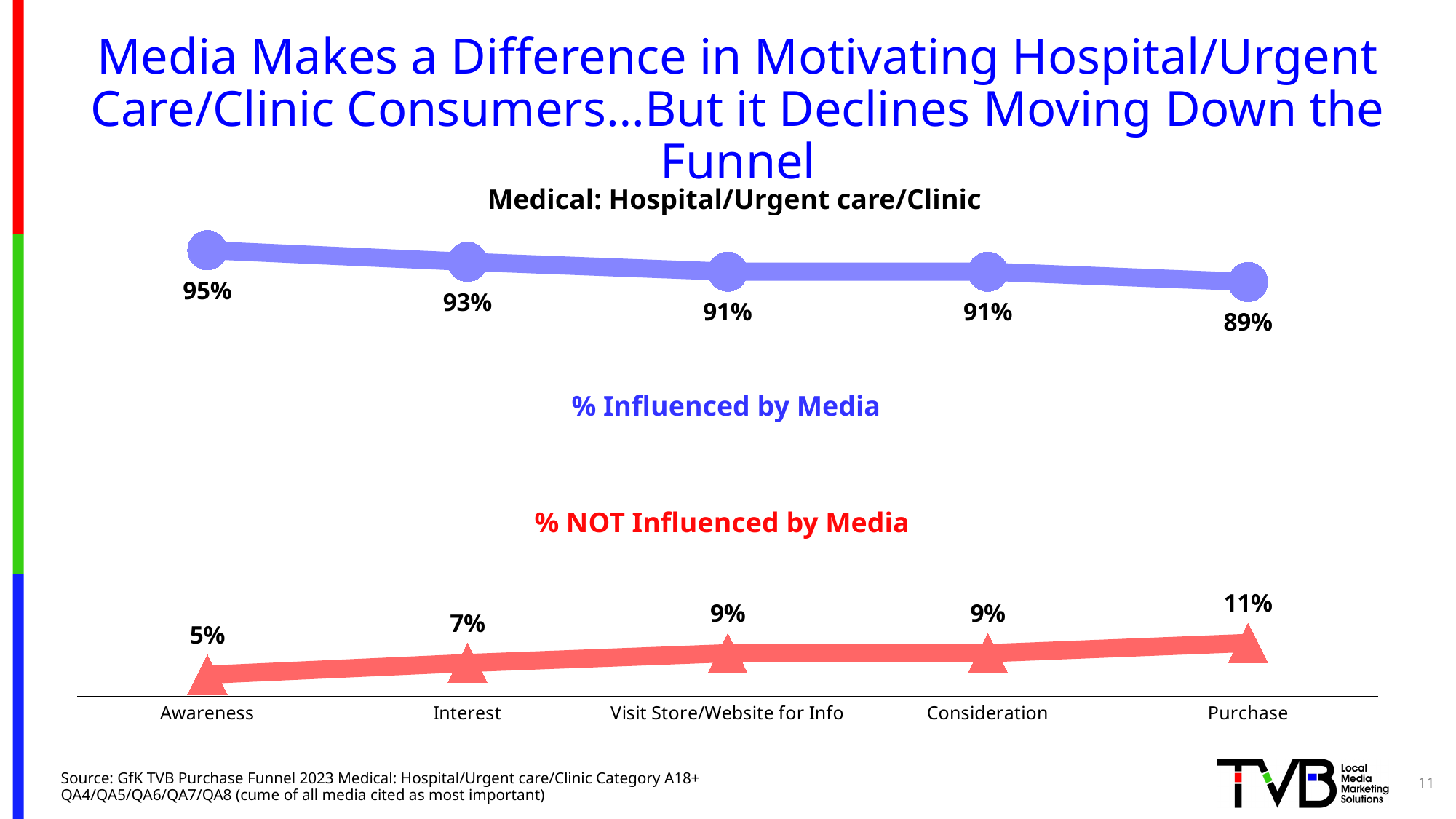
Does the % Influenced by Media series rise or fall moving from Awareness to Purchase? Fall What kind of chart is shown on the slide? Line chart How many data series are plotted on the chart? 2 What is the % Influenced by Media value for Awareness? 95% Which funnel stage has the highest % NOT Influenced by Media value? Purchase What is the % NOT Influenced by Media value for Purchase? 11% Which is larger: the % NOT Influenced by Media value for Awareness or for Visit Store/Website for Info? Visit Store/Website for Info What is the % NOT Influenced by Media value for Interest? 7% What is the difference between the % Influenced by Media values for Awareness and Purchase? 6% What is the % Influenced by Media value for Consideration? 91% Which funnel stage has the lowest % Influenced by Media value? Purchase How many funnel stages are shown on the x axis? 5